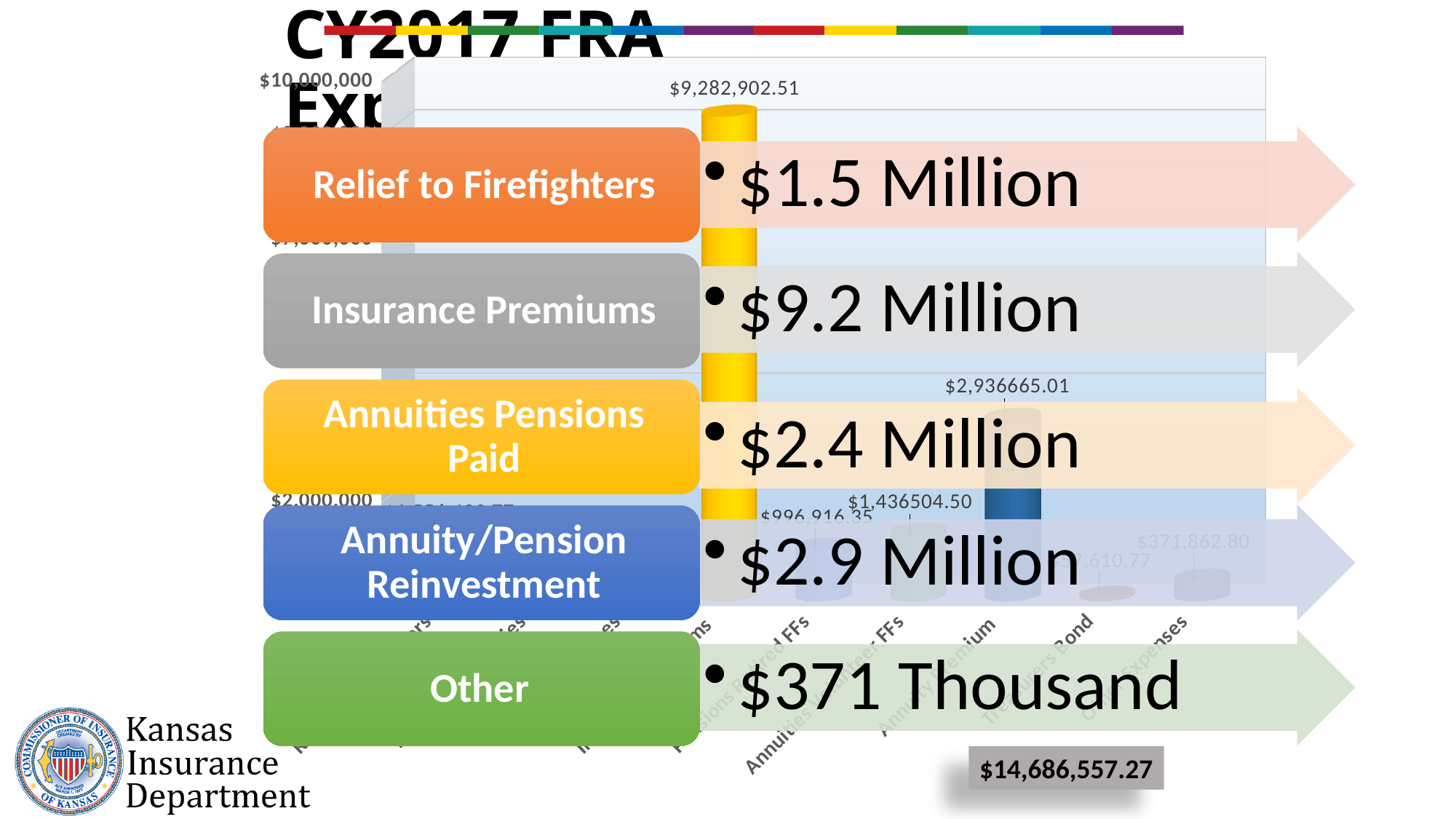
Which is larger, the bar labelled $9,282,902.51 or the bar labelled $371,862.80? $9,282,902.51 What kind of chart is shown on the slide? bar chart What total amount is printed in the grey box at the bottom right of the chart? $14,686,557.27 What is the highest value shown on the chart's vertical axis? $10,000,000 What is the value printed above the tallest bar in the chart? $9,282,902.51 Is the bar labelled $371,862.80 greater or less than $2,000,000? less Is the tallest bar in the chart greater or less than $2,000,000? greater